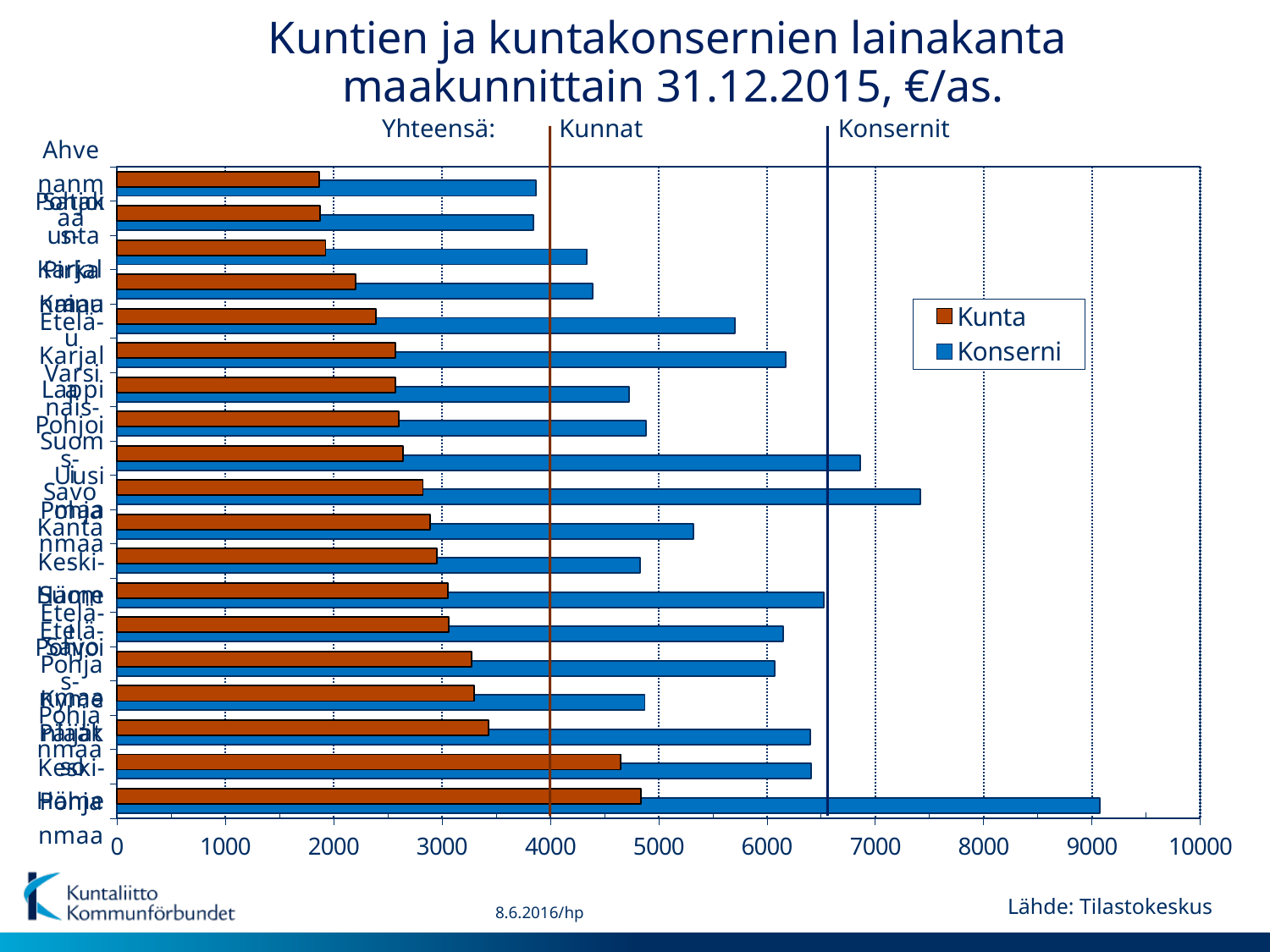
Is the longest Kunta bar greater or less than 4000? greater How many series does the legend list? 2 Is the longest Konserni bar greater or less than 9000? greater How many regions (categories) are plotted in the chart? 19 Is the Kunta value for Ahvenanmaa greater or less than 2000? less What is the title of the chart? Kuntien ja kuntakonsernien lainakanta maakunnittain 31.12.2015, €/as. What are the two series named in the legend? Kunta and Konserni For Ahvenanmaa, which is larger, the Kunta value or the Konserni value? Konserni What kind of chart is shown on the slide? bar chart In every region, which series has the longer bar, Kunta or Konserni? Konserni Do the Kunta bars increase or decrease in length going from the top of the chart to the bottom? increase